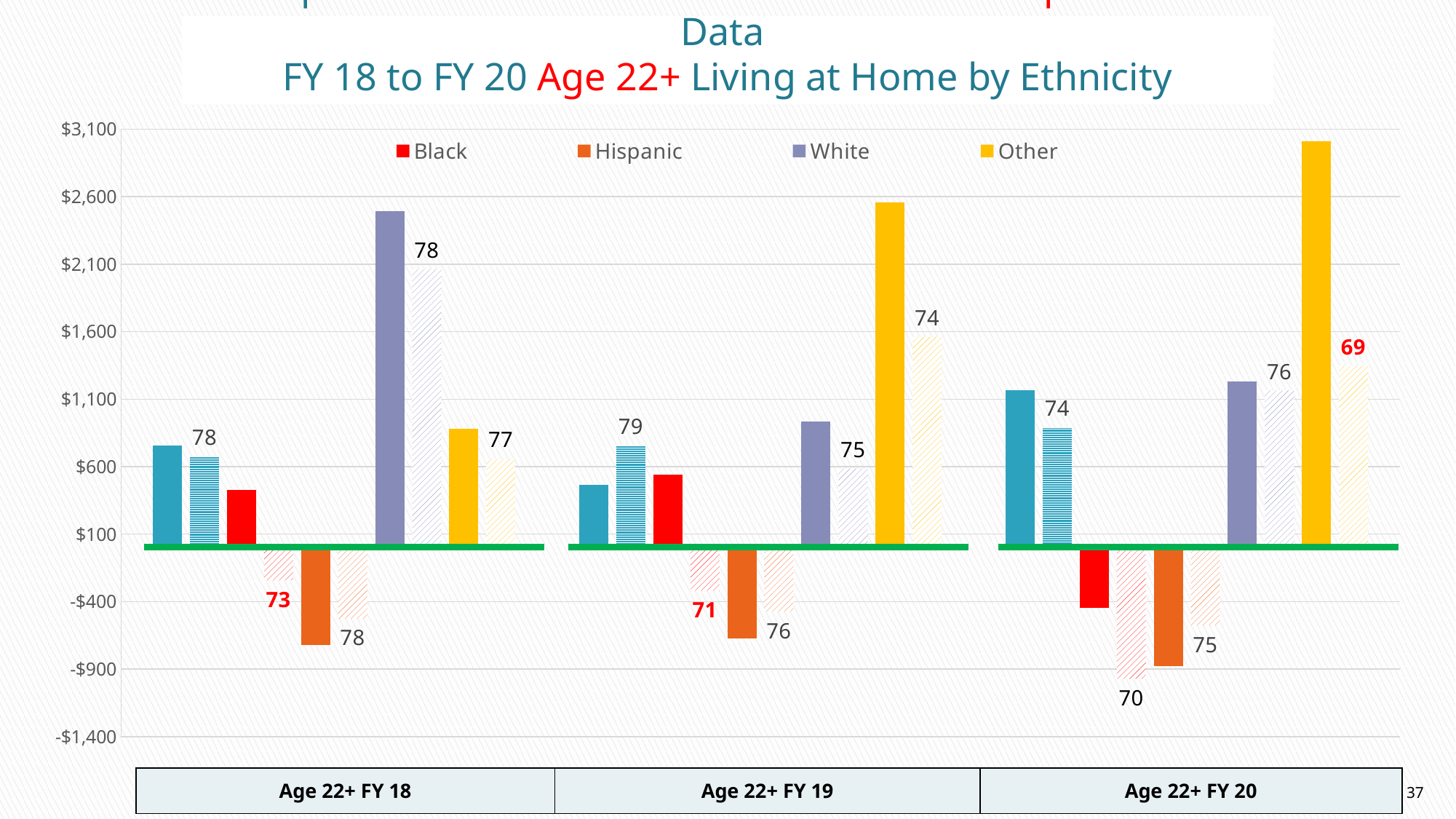
How many series does the legend list? 4 Is the value for Other in Age 22+ FY 20 greater or less than $2,600? greater Is the value for Hispanic in Age 22+ FY 18 greater or less than -$400? less Is the value for Black in Age 22+ FY 20 greater or less than $100? less In the Age 22+ FY 19 group, which is larger, the White bar or the Other bar? Other Across the three groups, in which group is the White bar the highest? Age 22+ FY 18 What kind of chart is shown on the slide? bar chart How many fiscal-year groups are shown along the x axis? 3 In the Age 22+ FY 20 group, which ethnicity has the lowest bar? Hispanic In the Age 22+ FY 20 group, which ethnicity has the highest bar? Other What colour does the legend use for Hispanic? orange